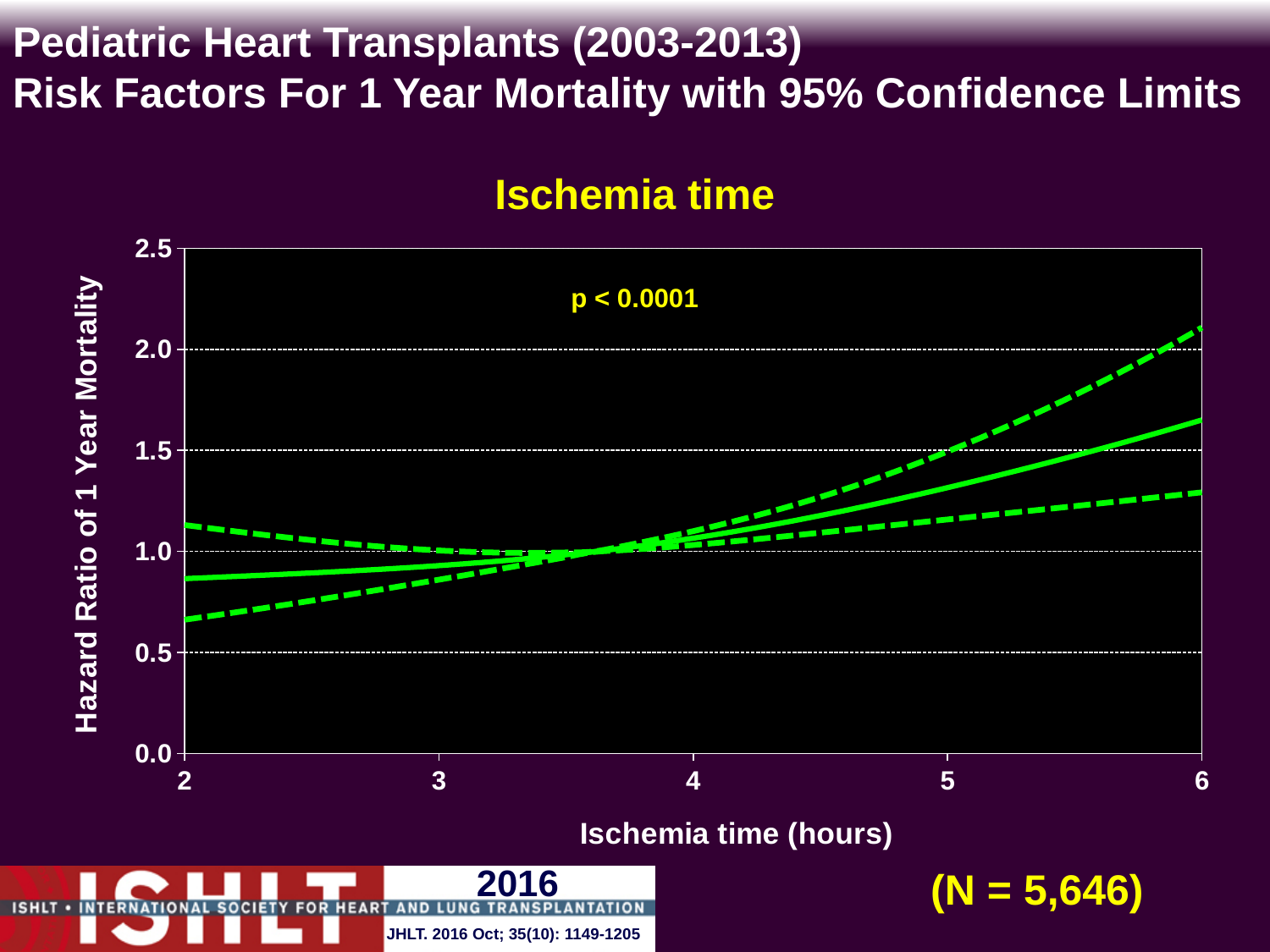
Does the solid hazard ratio line rise or fall as ischemia time increases from 2 to 6 hours? rises What is the label of the x axis? Ischemia time (hours) Is the upper confidence limit (upper dashed line) at 6 hours greater or less than 1.5? greater Is the lower confidence limit (lower dashed line) at 2 hours greater or less than 0.5? greater Is the hazard ratio (solid line) larger at 2 hours or at 6 hours of ischemia time? 6 hours Is the lower confidence limit (lower dashed line) at 6 hours greater or less than 1.0? greater What p-value is printed on the chart? p < 0.0001 What kind of chart is shown on the slide? line chart How many lines are plotted on the chart? 3